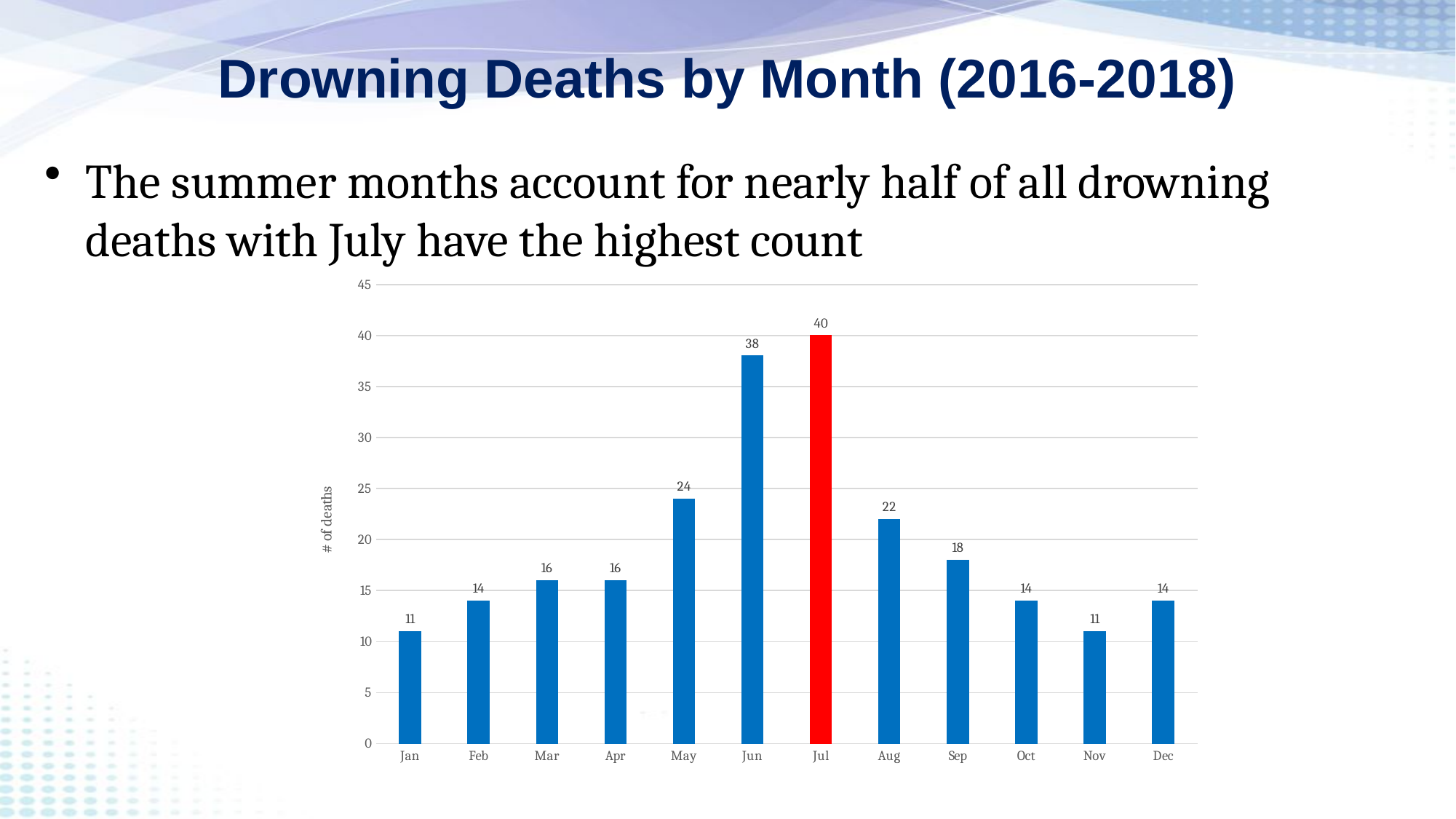
How many months are shown on the x axis? 12 What is the number of deaths for Jul? 40 Do the values rise or fall from Jul to Nov? Fall What is the number of deaths for May? 24 What is the number of deaths for Sep? 18 Which month has more deaths, Mar or Oct? Mar Which months have the lowest number of deaths? Jan and Nov Which month has the highest number of deaths? Jul What kind of chart is shown on the slide? Bar chart Which bar is coloured red instead of blue? Jul Is the value for Jun greater or less than 35? greater What is the difference in deaths between Jun and Aug? 16